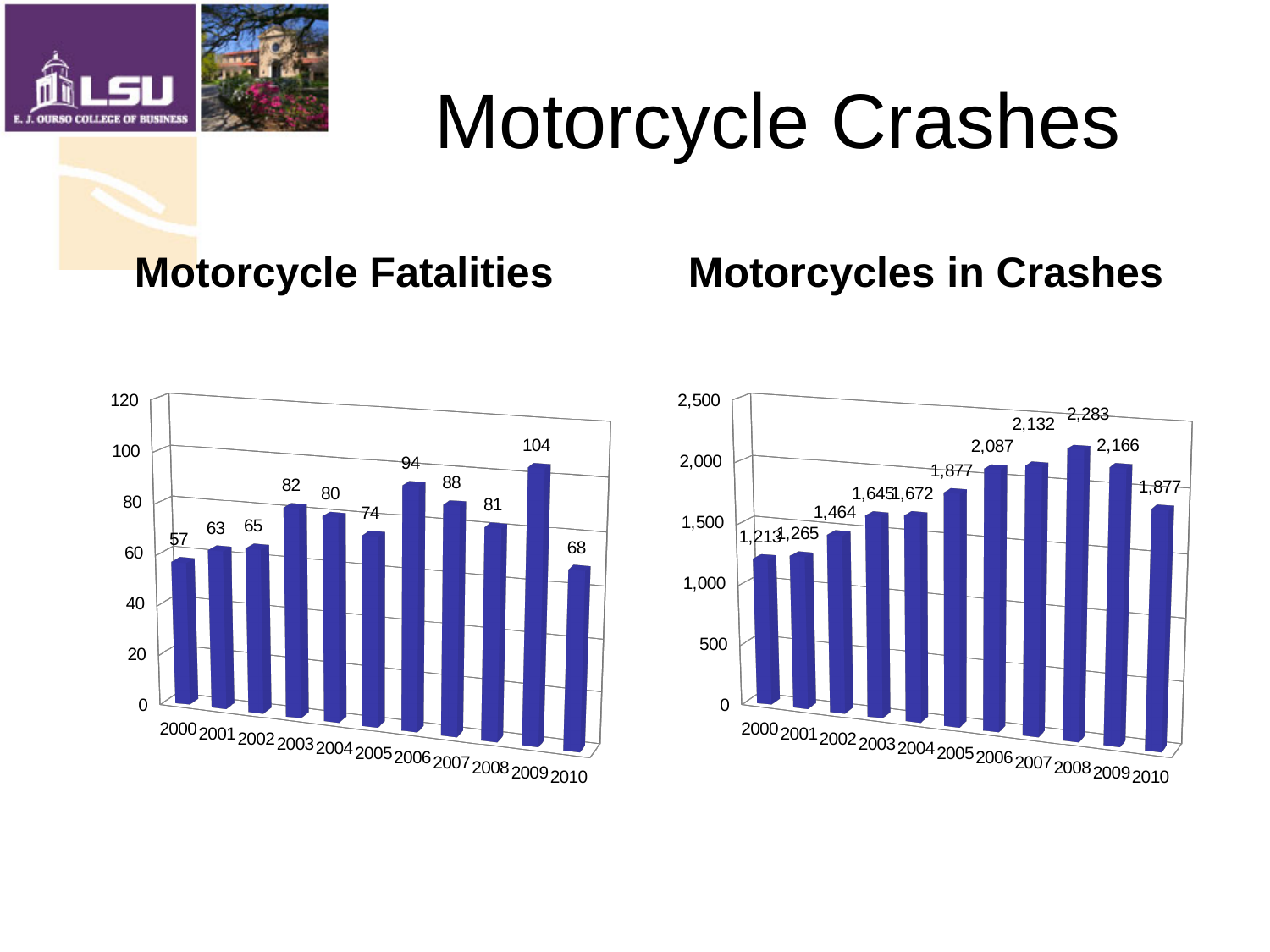
In the Motorcycle Fatalities chart, how many years are shown on the x axis? 11 In the Motorcycles in Crashes chart, what is the difference between the values for 2008 and 2009? 117 In the Motorcycle Fatalities chart, what is the difference between the values for 2009 and 2010? 36 In the Motorcycles in Crashes chart, which year has the highest value? 2008 In the Motorcycle Fatalities chart, which year has the lowest value? 2000 In the Motorcycles in Crashes chart, do the values rise or fall from 2000 to 2008? Rise What is the title of the chart on the right side of the slide? Motorcycles in Crashes In the Motorcycles in Crashes chart, what is the value for 2008? 2,283 What kind of chart is the Motorcycle Fatalities chart? Bar chart In the Motorcycles in Crashes chart, is the value for 2006 greater or less than 2,000? greater In the Motorcycle Fatalities chart, what is the value for 2009? 104 In the Motorcycle Fatalities chart, which is larger, the value for 2006 or the value for 2007? 2006